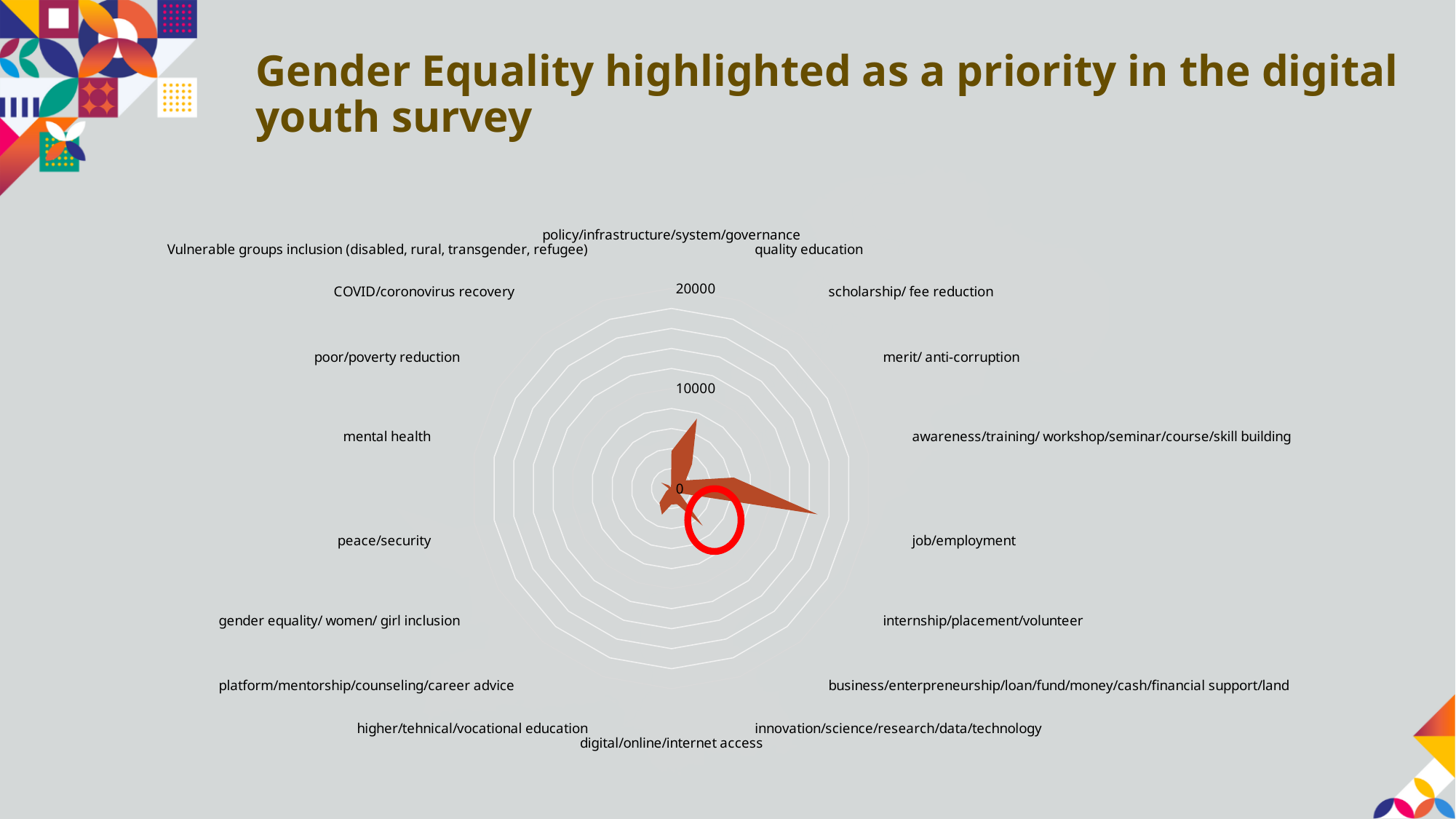
What is the title of the slide containing the radar chart? Gender Equality highlighted as a priority in the digital youth survey What is the highest axis tick value shown on the radar chart? 20000 How many categories are plotted around the radar chart? 18 Is the value for job/employment greater or less than 10000? greater Which has the larger value, job/employment or peace/security? job/employment Which category has the highest value in the radar chart? job/employment Is the value for job/employment greater or less than 20000? less Is the value for mental health greater or less than 10000? less What kind of chart is shown on the slide? radar chart